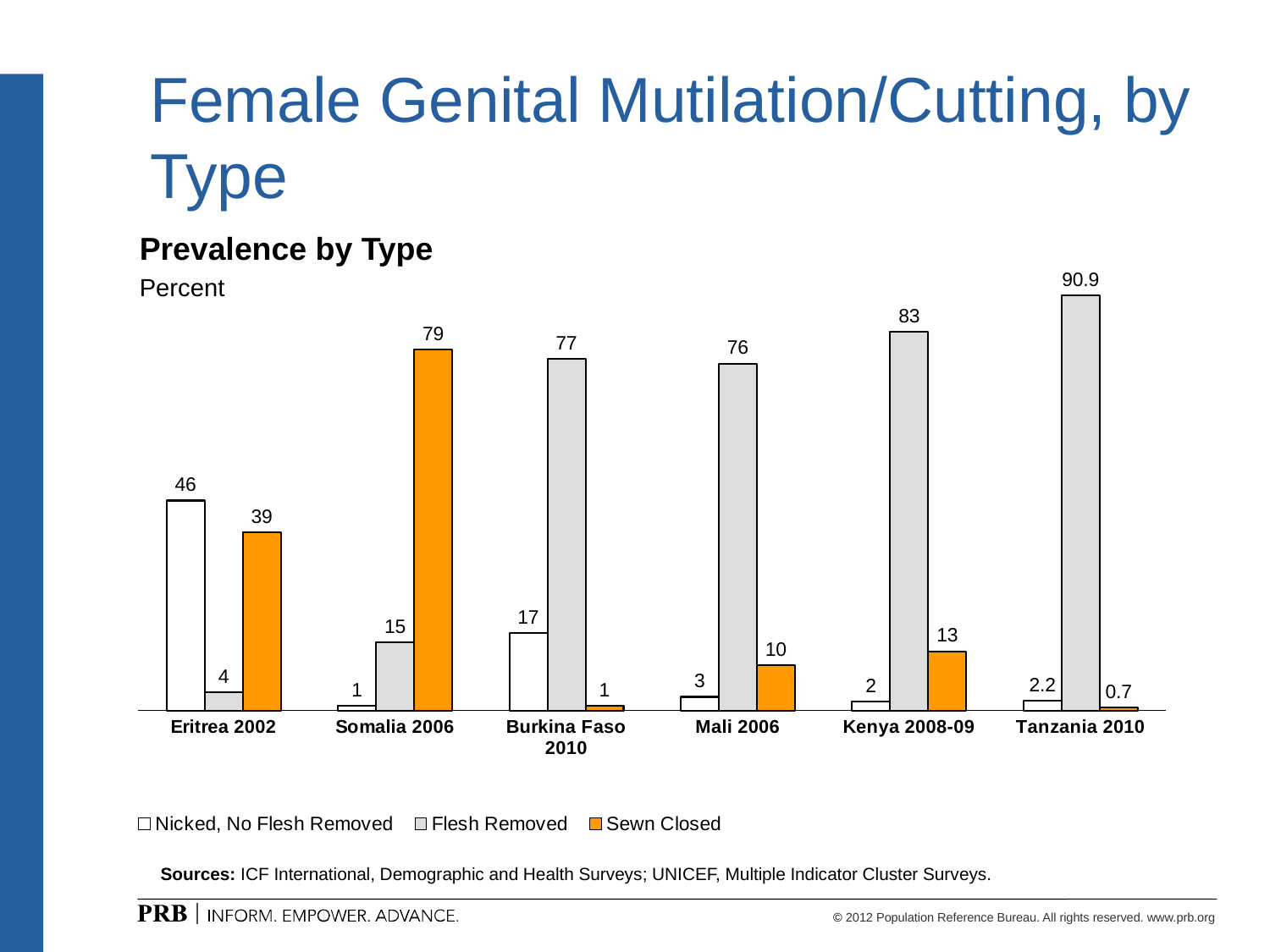
What is the difference between the Flesh Removed values for Kenya 2008-09 and Mali 2006? 7 How many series does the legend list? 3 What is the value for Nicked, No Flesh Removed in Burkina Faso 2010? 17 How many countries are shown on the x axis? 6 What is the value for Sewn Closed in Somalia 2006? 79 What is the value for Flesh Removed in Tanzania 2010? 90.9 Which country has the lowest value for Sewn Closed? Tanzania 2010 Which country has the highest value for Flesh Removed? Tanzania 2010 Which is larger: Sewn Closed in Eritrea 2002 or Sewn Closed in Kenya 2008-09? Eritrea 2002 What is the value for Nicked, No Flesh Removed in Eritrea 2002? 46 Which series is shown in orange in the legend? Sewn Closed What kind of chart is shown on the slide? Bar chart